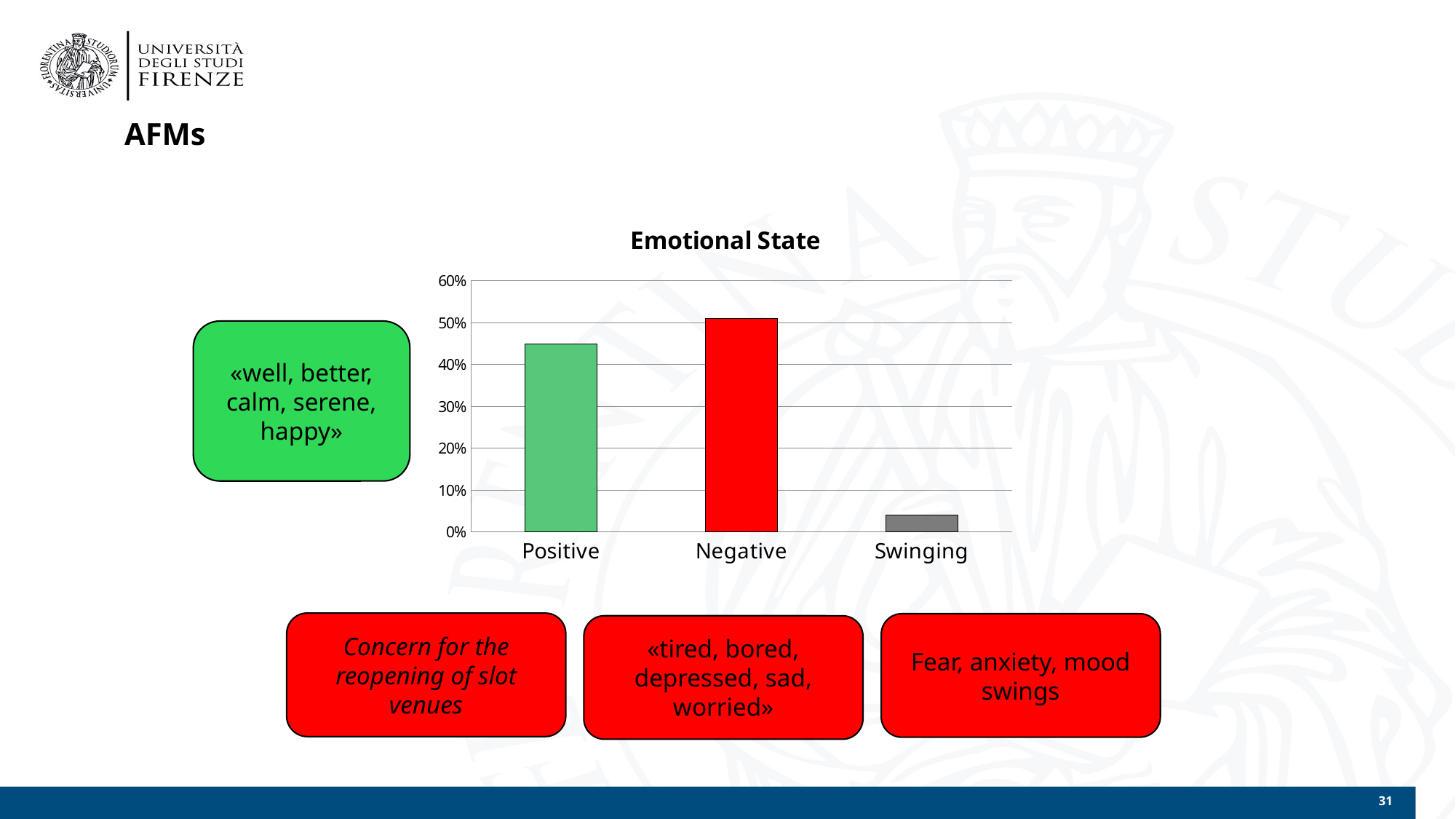
Is the value for Positive greater or less than 40%? greater Which category has the highest value in the chart? Negative What colour is the bar for Negative? red Which category has the lowest value in the chart? Swinging Is the value for Swinging greater or less than 10%? less Which is larger, the value for Positive or the value for Swinging? Positive How many categories are shown on the x axis of the chart? 3 What type of chart is shown on the slide? bar chart Which is larger, the value for Positive or the value for Negative? Negative What is the title of the chart? Emotional State Is the value for Positive greater or less than 50%? less